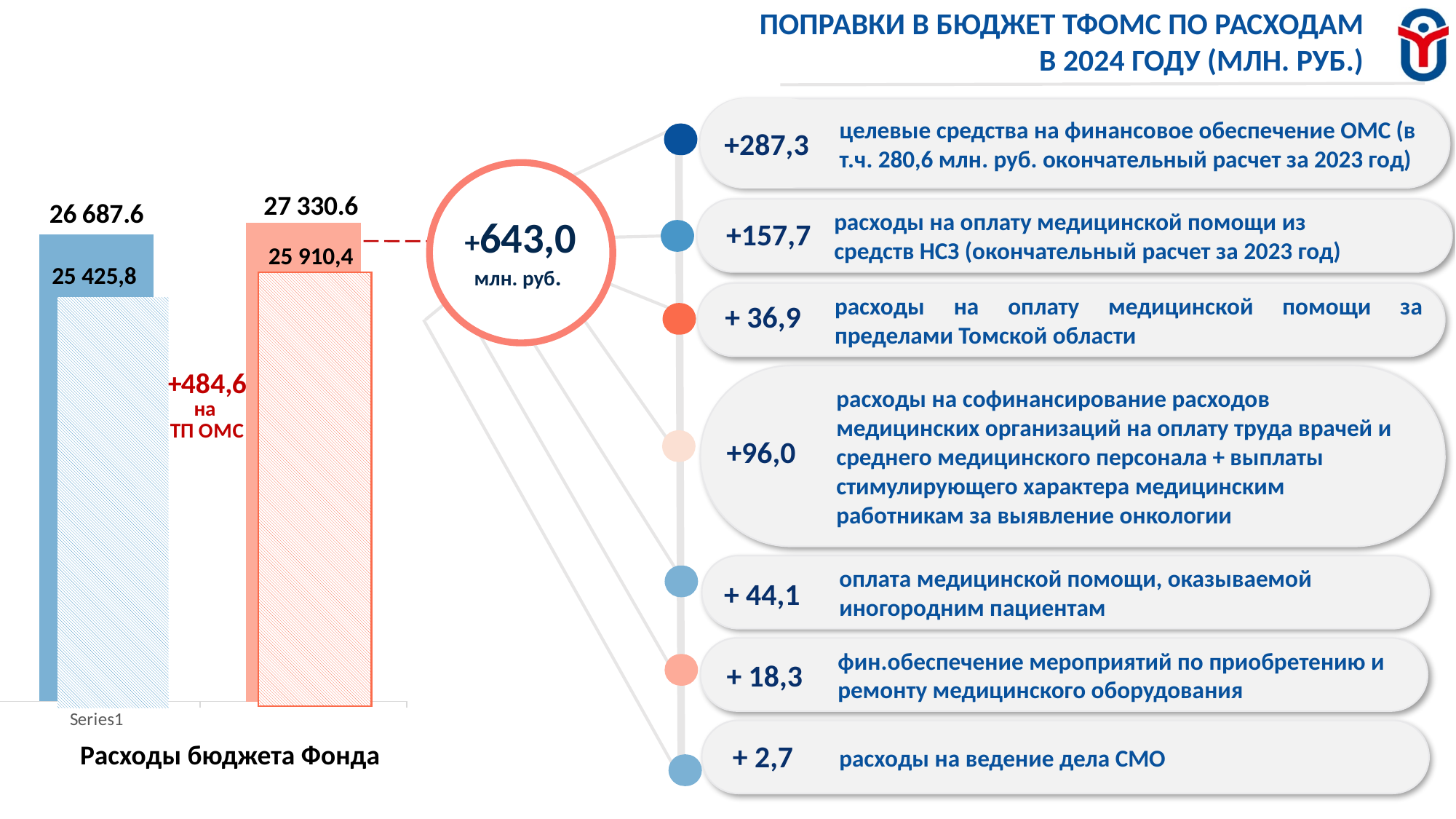
In the «Расходы бюджета Фонда» chart, what value is printed above the red (right) bar? 27 330.6 In the «Расходы бюджета Фонда» chart, what is the difference between the hatched values 25 910,4 and 25 425,8? 484,6 What caption is printed below the bar chart on the left of the slide? Расходы бюджета Фонда In the «Расходы бюджета Фонда» chart, what value is printed above the blue (left) bar? 26 687.6 What kind of chart is shown on the left of the slide under the heading «Расходы бюджета Фонда»? bar chart In the «Расходы бюджета Фонда» chart, what value is printed inside the blue (left) bar above its hatched section? 25 425,8 Do the bar totals in the «Расходы бюджета Фонда» chart rise or fall from left to right? rise What label appears on the horizontal axis of the bar chart? Series1 In the «Расходы бюджета Фонда» chart, which bar is taller, the blue (left) one or the red (right) one? the red (right) bar How many bars are plotted in the «Расходы бюджета Фонда» chart? 2 In the «Расходы бюджета Фонда» chart, what is the difference between the red bar's total (27 330.6) and the blue bar's total (26 687.6)? 643,0 In the «Расходы бюджета Фонда» chart, what value is printed inside the red (right) bar above its hatched section? 25 910,4